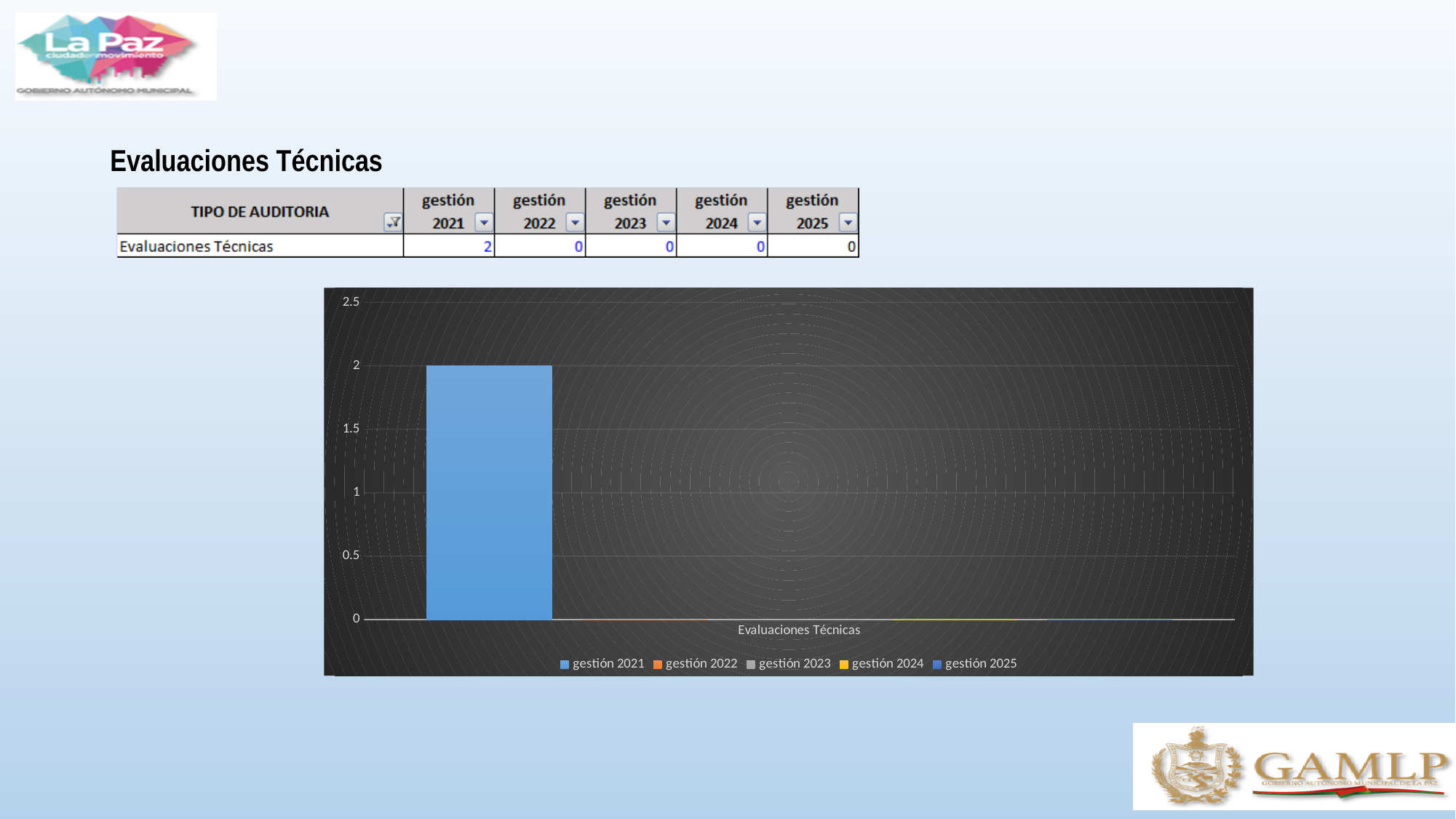
What is the value for gestión 2021 in the chart? 2 How many series does the chart legend list? 5 Which is larger, the value for gestión 2021 or the value for gestión 2023? gestión 2021 What is the highest value shown on the chart's vertical axis? 2.5 What is the category label shown on the x axis of the chart? Evaluaciones Técnicas Is the value for gestión 2021 greater or less than 1.5? greater What is the value for gestión 2022 for Evaluaciones Técnicas? 0 What kind of chart is shown on the slide? bar chart How many categories are shown on the x axis of the chart? 1 Which series has the highest value in the chart? gestión 2021 What is the value for gestión 2025 for Evaluaciones Técnicas? 0 What is the difference between the value for gestión 2021 and the value for gestión 2024? 2